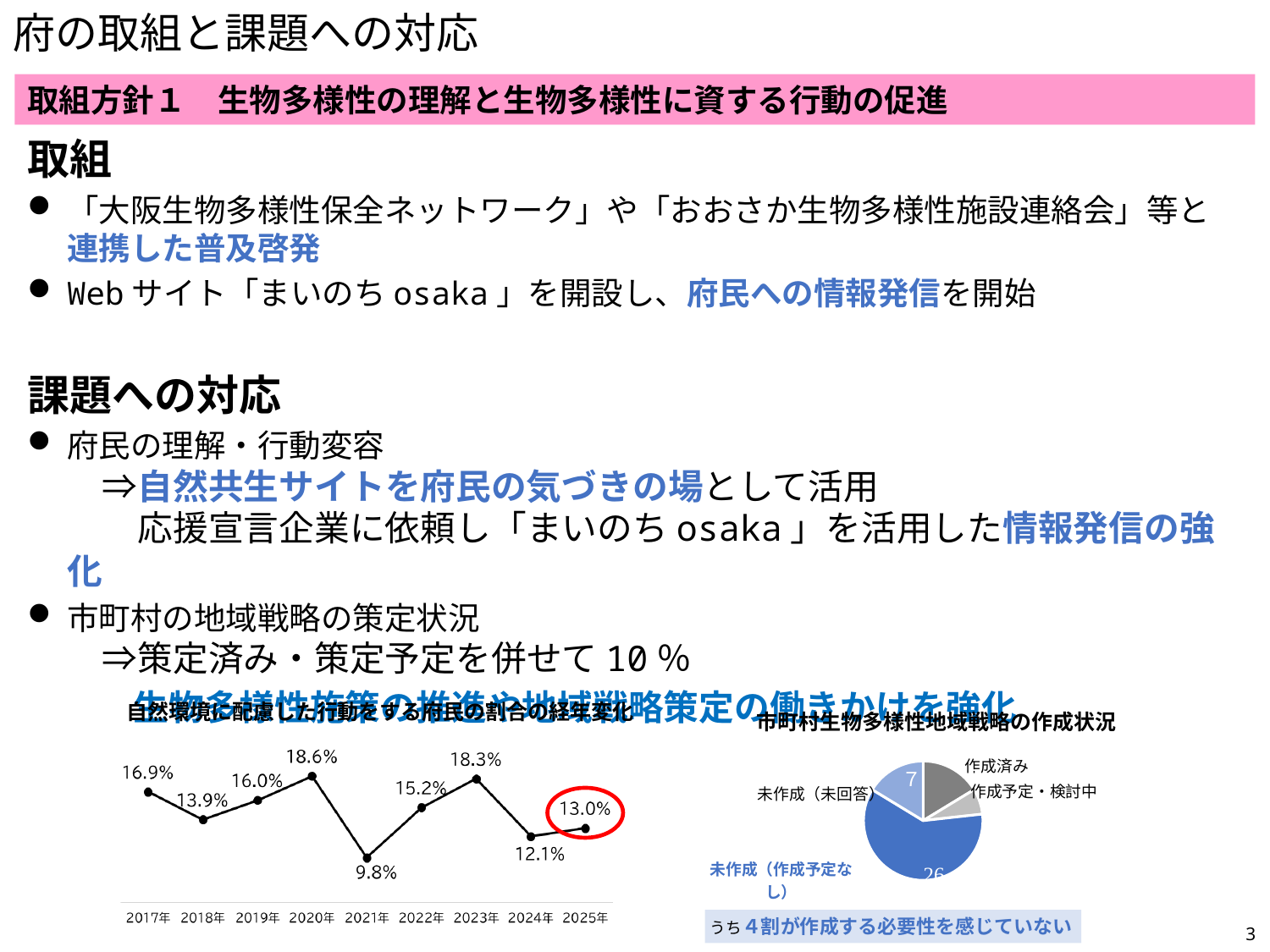
On the line chart titled 自然環境に配慮した行動をする府民の割合の経年変化, how many years are plotted? 9 What kind of chart is the chart titled 自然環境に配慮した行動をする府民の割合の経年変化? Line chart What kind of chart is the chart titled 市町村生物多様性地域戦略の作成状況? Pie chart On the pie chart titled 市町村生物多様性地域戦略の作成状況, what value is shown for the 未作成（未回答） slice? 7 On the line chart titled 自然環境に配慮した行動をする府民の割合の経年変化, what is the value for 2025年? 13.0% On the line chart titled 自然環境に配慮した行動をする府民の割合の経年変化, which year has the lowest value? 2021年 On the line chart titled 自然環境に配慮した行動をする府民の割合の経年変化, which year has the highest value? 2020年 On the line chart titled 自然環境に配慮した行動をする府民の割合の経年変化, which is larger, the value for 2017年 or the value for 2019年? 2017年 On the line chart titled 自然環境に配慮した行動をする府民の割合の経年変化, what is the value for 2020年? 18.6% On the line chart titled 自然環境に配慮した行動をする府民の割合の経年変化, does the value rise or fall from 2020年 to 2021年? Fall On the line chart titled 自然環境に配慮した行動をする府民の割合の経年変化, what is the value for 2021年? 9.8% On the line chart titled 自然環境に配慮した行動をする府民の割合の経年変化, what is the difference between the 2023年 value and the 2024年 value? 6.2%